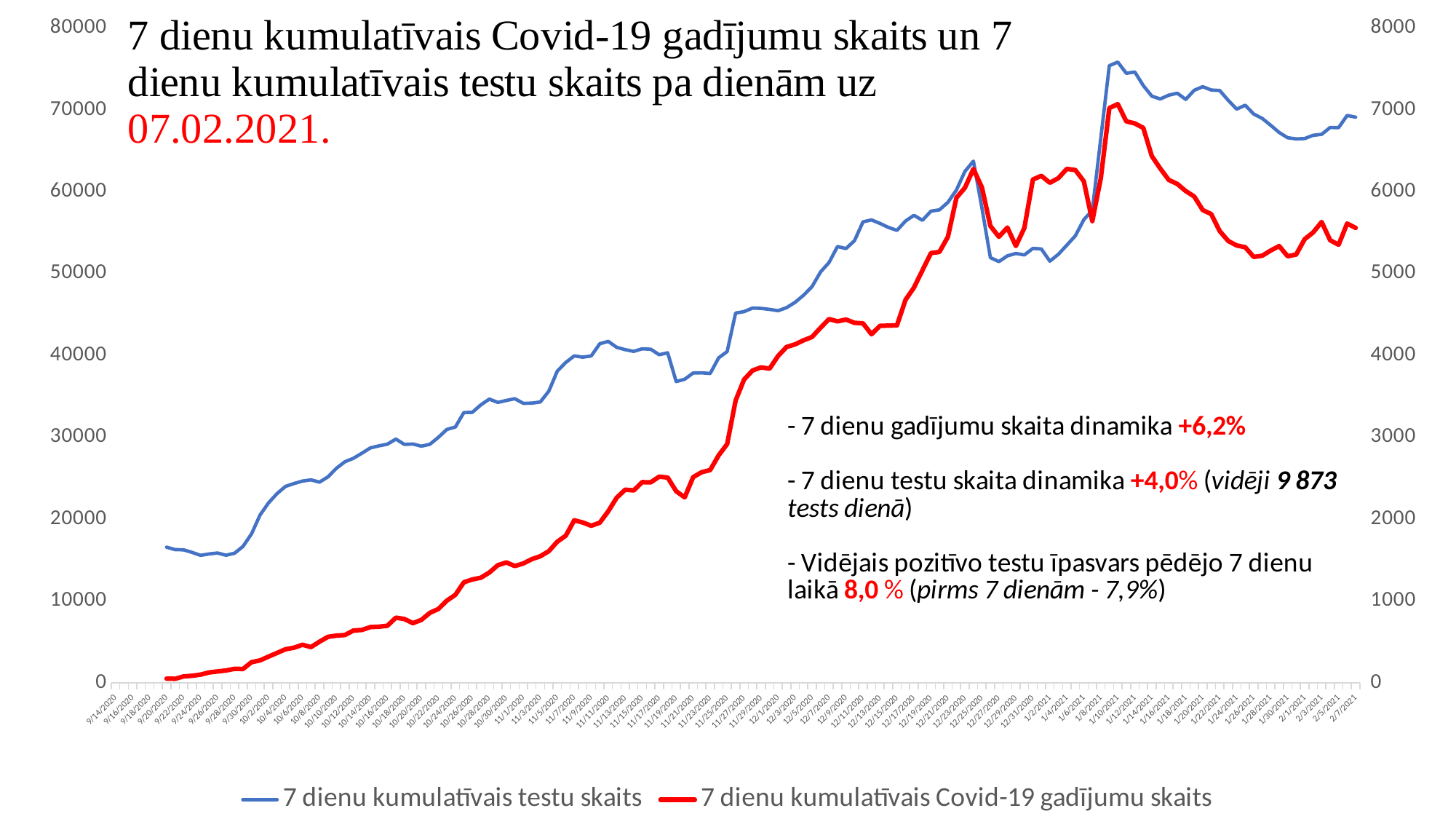
On the right axis, is the value of the red line at 9/20/2020 greater or less than 1000? less On the left axis, is the value of the blue line at 2/7/2021 greater or less than 60000? greater How many series does the legend list? 2 On the left axis, is the value of the blue line at 9/20/2020 greater or less than 20000? less What date is shown in red in the chart title? 07.02.2021. What is the maximum value shown on the right vertical axis? 8000 Does the red line (7 dienu kumulatīvais Covid-19 gadījumu skaits) rise or fall between 1/10/2021 and 1/26/2021? fall Which series is drawn in red? 7 dienu kumulatīvais Covid-19 gadījumu skaits What kind of chart is shown on the slide? line chart Overall, does the blue line (7 dienu kumulatīvais testu skaits) rise or fall from 9/20/2020 to 2/7/2021? rise